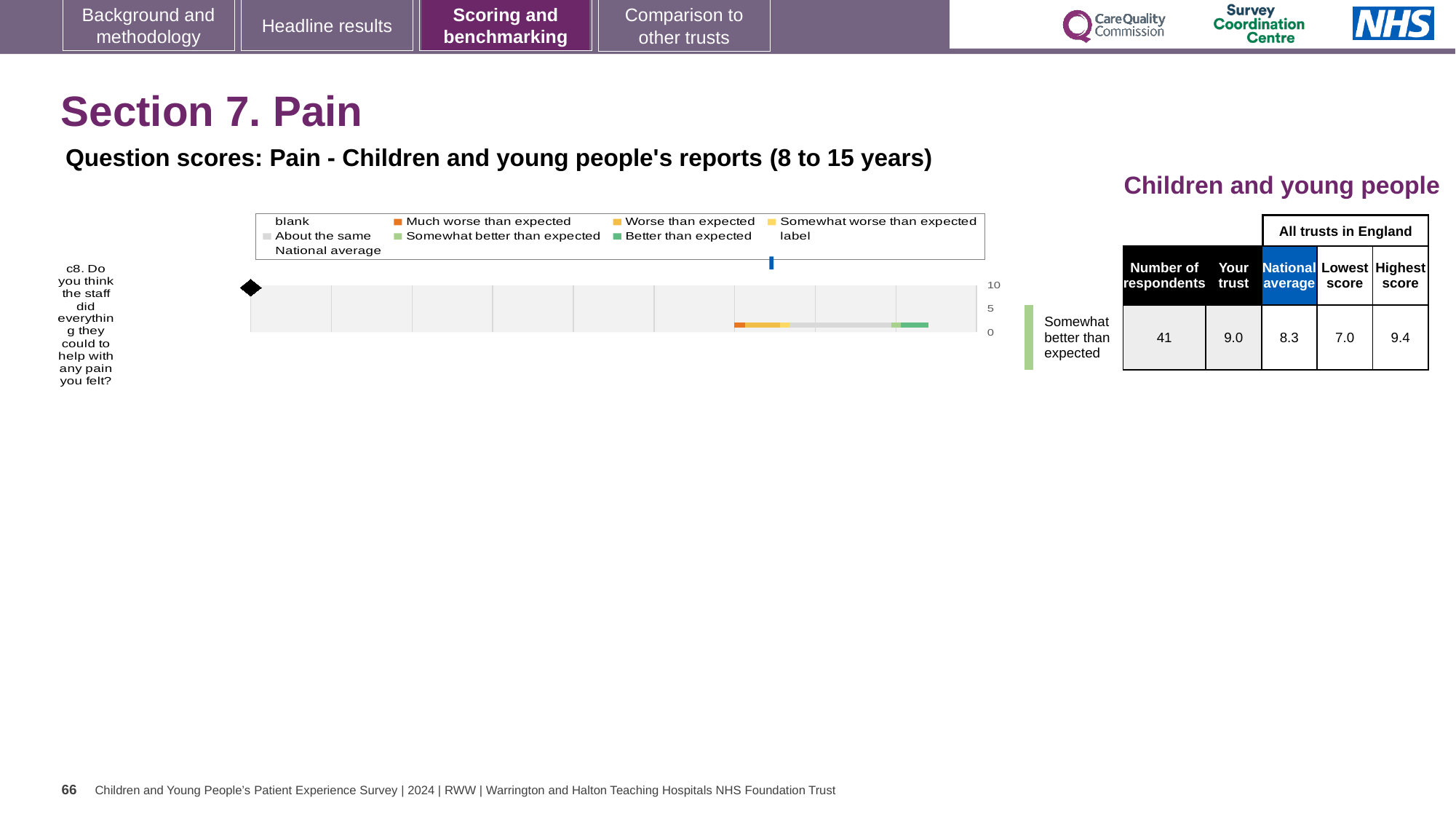
What is the highest score among all trusts in England for question c8? 9.4 By how much does the trust's score for c8 exceed the national average? 0.7 What is the 'Your trust' score for question c8? 9.0 What kind of chart is used to show the benchmarking result for question c8? bar chart Which benchmarking category does the trust's score for c8 fall into? Somewhat better than expected How many survey questions are plotted in the chart? 1 What is the lowest score among all trusts in England for question c8? 7.0 How many respondents answered question c8? 41 What is the national average score for question c8? 8.3 What is the difference between the highest and lowest scores for question c8? 2.4 What is the maximum value shown on the chart's score axis? 10 Which is larger for question c8: the trust's score or the national average? Your trust